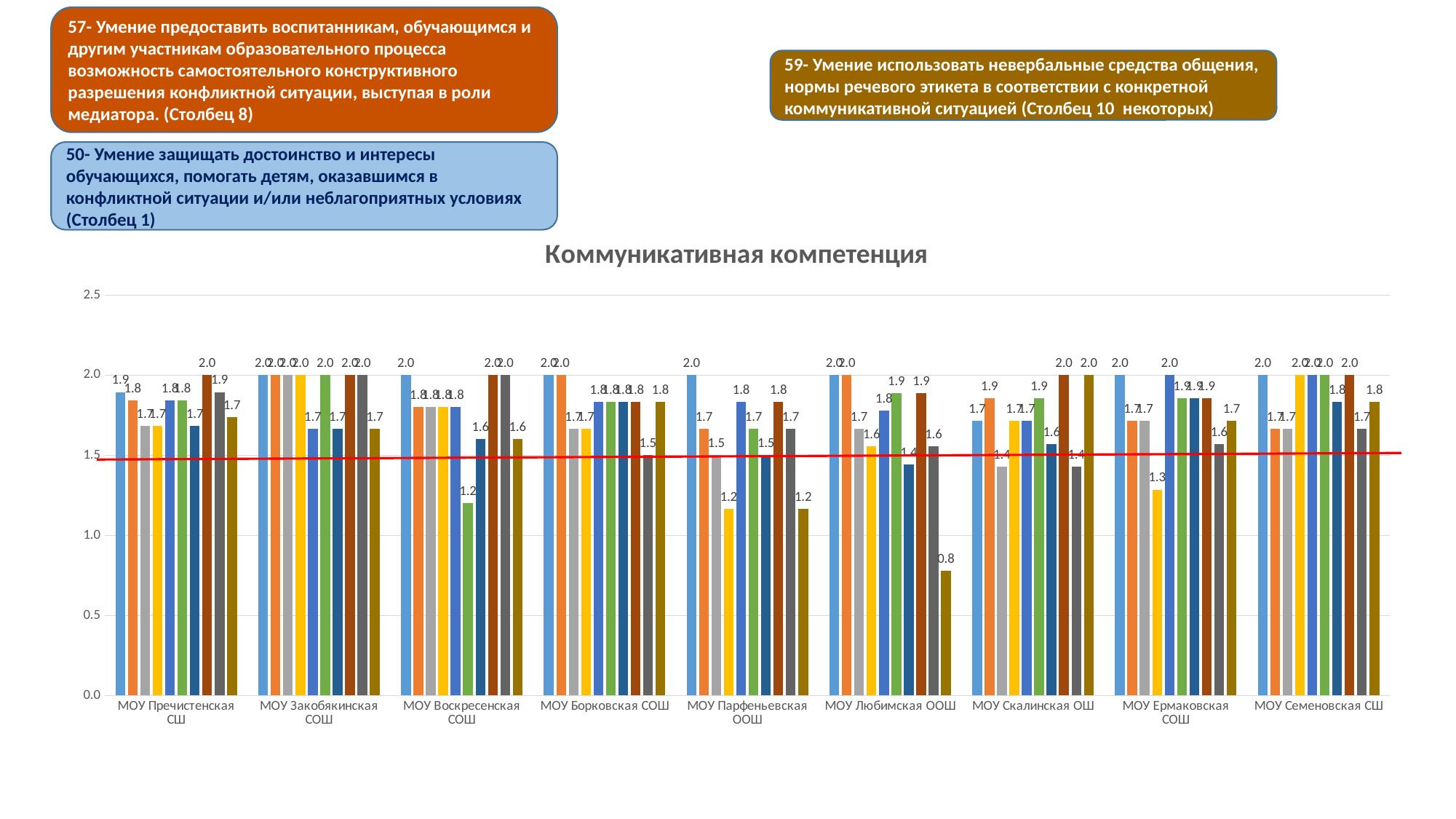
What is the title of the chart? Коммуникативная компетенция What is the value of the lowest bar in the МОУ Воскресенская СОШ group? 1.2 Which is larger: the lowest bar for МОУ Любимская ООШ or the lowest bar for МОУ Ермаковская СОШ? МОУ Ермаковская СОШ In the МОУ Любимская ООШ group, what is the difference between the highest bar (2.0) and the lowest bar (0.8)? 1.2 What is the value of the lowest bar in the МОУ Ермаковская СОШ group? 1.3 What is the value of the lowest bar in the МОУ Любимская ООШ group? 0.8 Is the lowest bar for МОУ Любимская ООШ greater or less than 1.0? less How many bars are plotted for each school in the chart? 10 What is the value of the first (blue) bar for МОУ Пречистенская СШ? 1.9 Which school has the lowest single bar in the whole chart? МОУ Любимская ООШ How many schools (categories) are shown on the x axis of the chart? 9 What type of chart is shown on the slide? bar chart